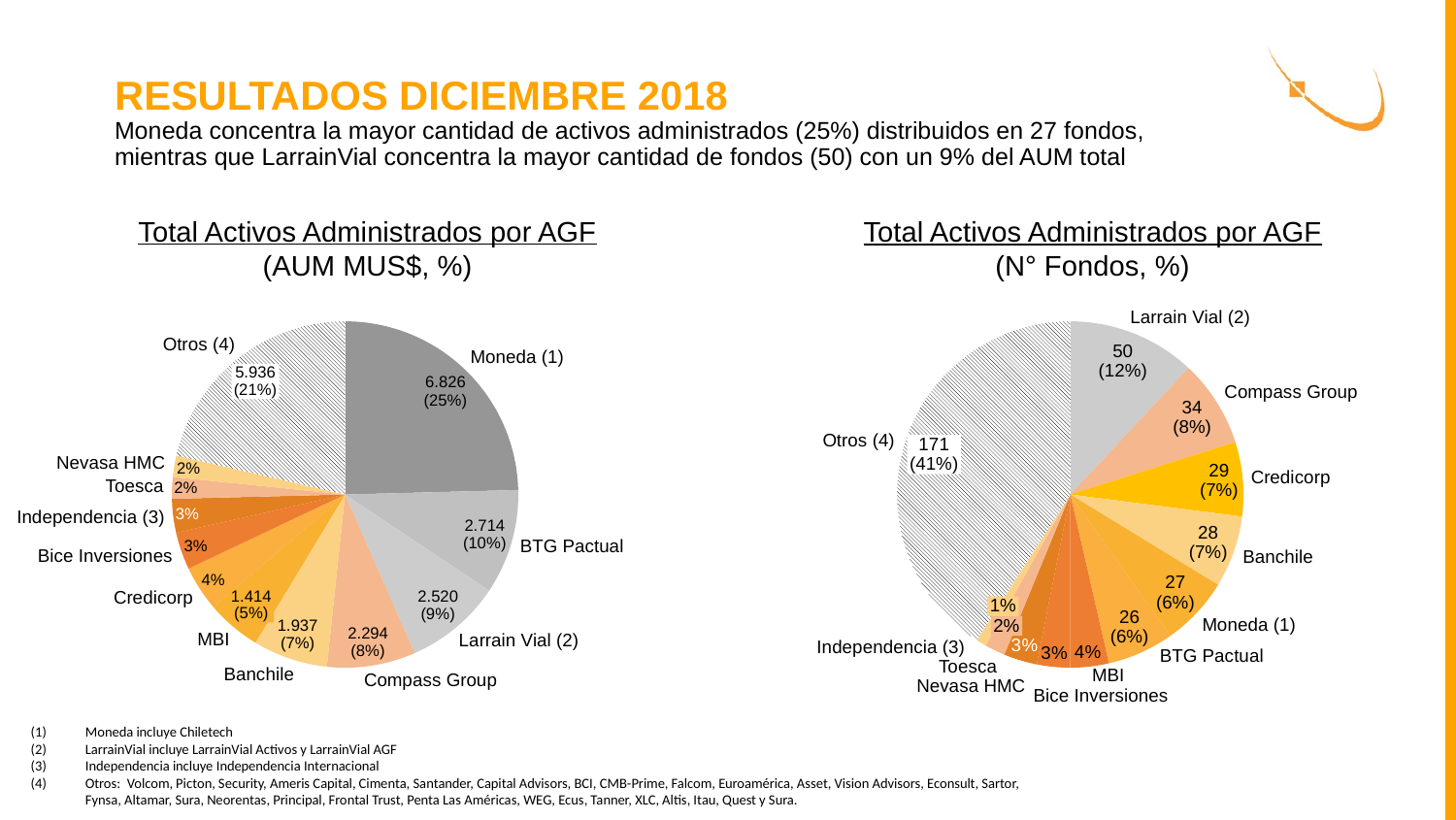
How many slices does the left chart (AUM MUS$, %) have? 12 In the right chart (N° Fondos, %), which category has the largest slice? Otros (4) In the left chart (AUM MUS$, %), what percentage share does BTG Pactual have? 10% In the right chart (N° Fondos, %), how many funds does Larrain Vial (2) have? 50 In the right chart (N° Fondos, %), what percentage share does Nevasa HMC have? 1% What type of chart is used for the right chart (N° Fondos, %)? Pie chart In the right chart (N° Fondos, %), what percentage share does Compass Group have? 8% In the left chart (AUM MUS$, %), which has a larger AUM, Banchile or MBI? Banchile In the left chart (AUM MUS$, %), which AGF has the largest slice? Moneda (1) In the right chart (N° Fondos, %), what is the difference in number of funds between Larrain Vial (2) and Compass Group? 16 In the left chart (AUM MUS$, %), what is the AUM value shown for Moneda (1)? 6.826 In the left chart (AUM MUS$, %), what is the difference between the AUM of Moneda (1) and BTG Pactual? 4.112